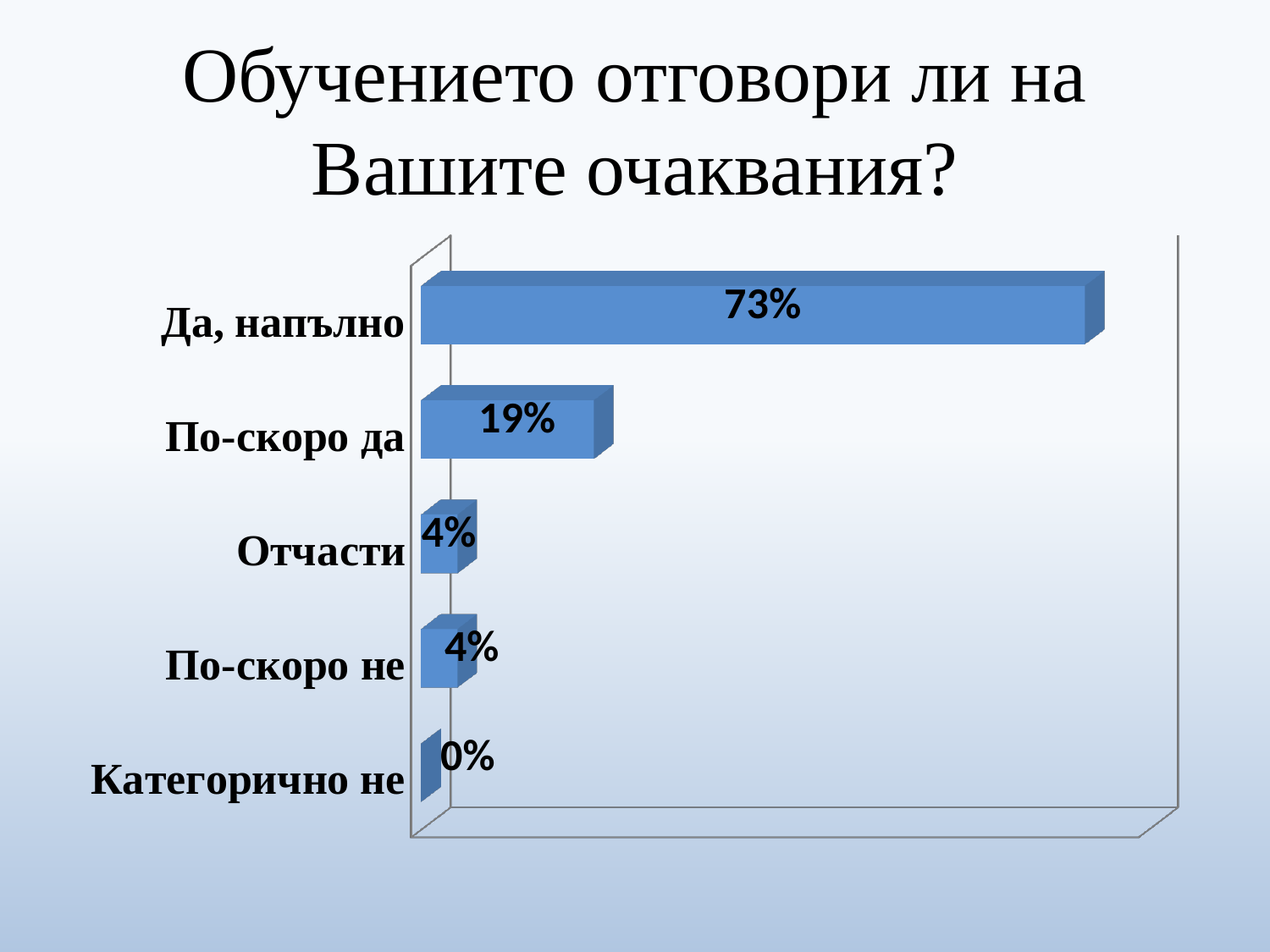
What is the value for "Да, напълно"? 73% Which category has the lowest value? Категорично не What kind of chart is shown on the slide? Bar chart What is the value for "Категорично не"? 0% Which is larger, the value for "По-скоро да" or the value for "По-скоро не"? По-скоро да What is the value for "Отчасти"? 4% What is the title of the slide? Обучението отговори ли на Вашите очаквания? Which category has the highest value? Да, напълно How many categories are shown in the chart? 5 What is the difference between the values for "Да, напълно" and "По-скоро да"? 54% What colour are the bars in the chart? Blue What is the value for "По-скоро да"? 19%